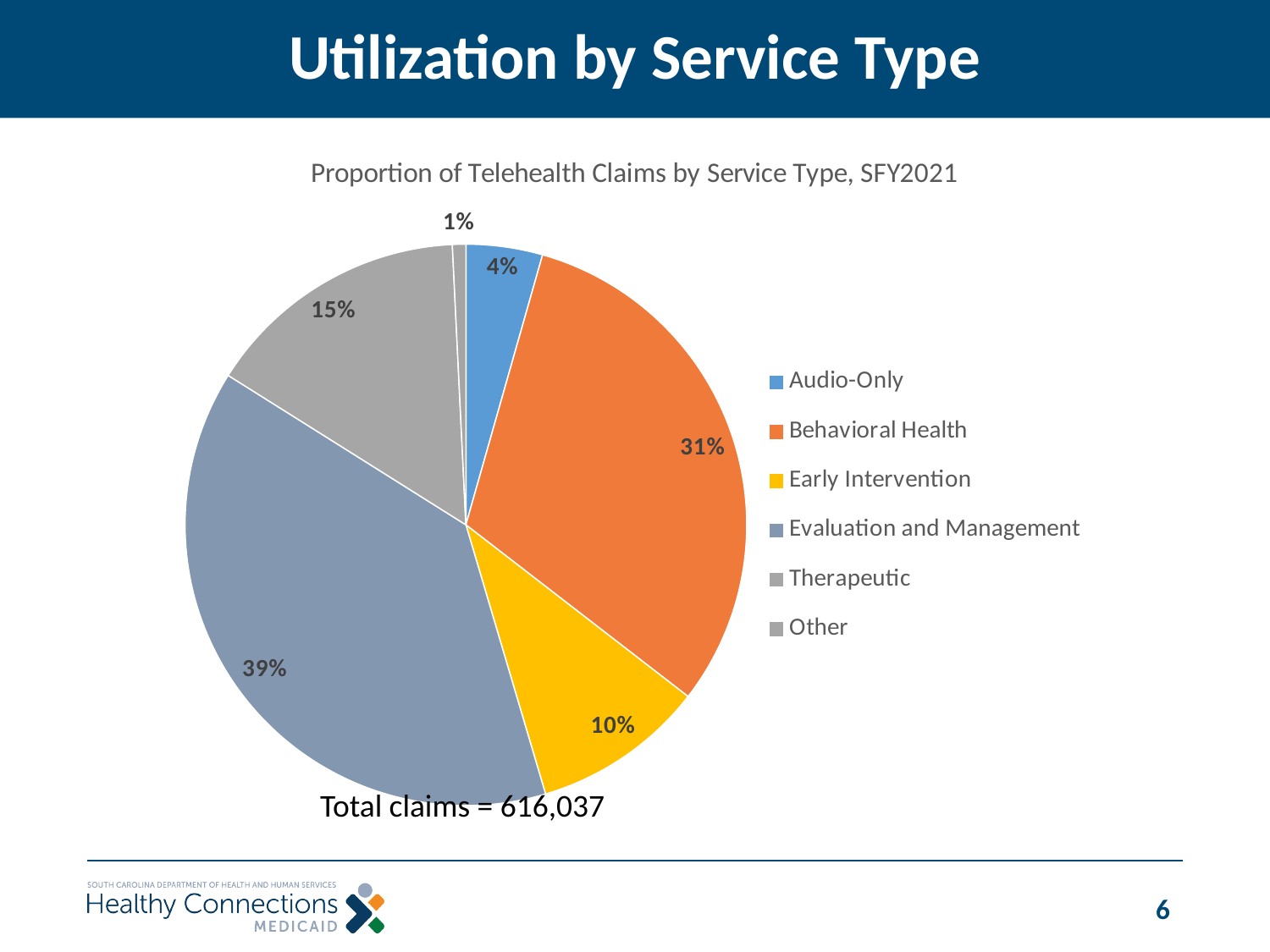
What is the title of the chart? Proportion of Telehealth Claims by Service Type, SFY2021 How many percentage points larger is the Evaluation and Management share than the Behavioral Health share? 8 percentage points What share of telehealth claims is Evaluation and Management? 39% How many service types are shown in the pie chart? 6 What share of telehealth claims is Therapeutic? 15% Which has a larger share of claims, Early Intervention or Therapeutic? Therapeutic Which service type has the largest share of telehealth claims? Evaluation and Management What kind of chart is shown on the slide? Pie chart What share of telehealth claims is Behavioral Health? 31% Which service type has the smallest share of telehealth claims? Other What is the total number of claims stated on the slide? 616,037 What share of telehealth claims is Audio-Only? 4%